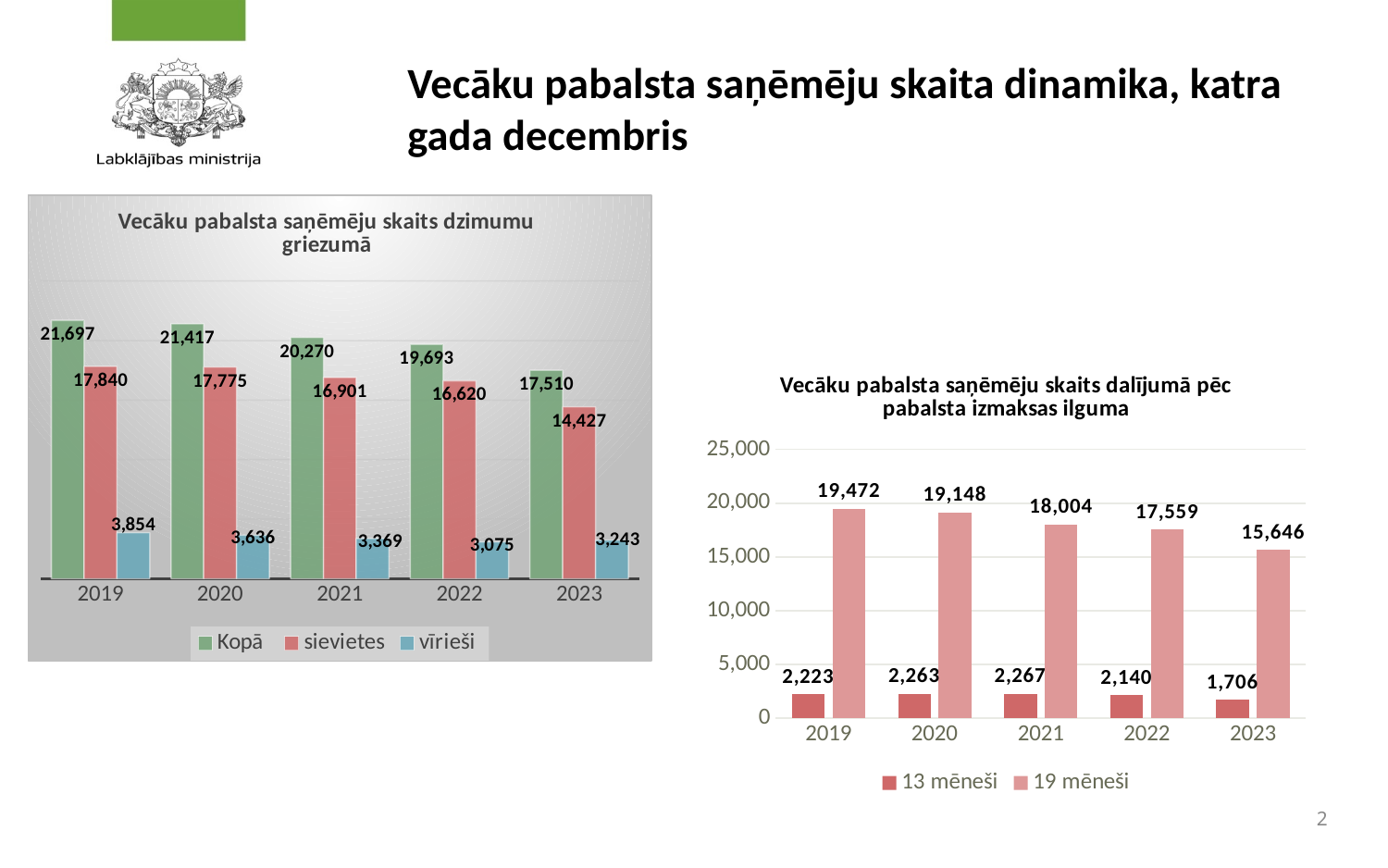
In the left chart (Vecāku pabalsta saņēmēju skaits dzimumu griezumā), what is the difference between the Kopā values for 2019 and 2023? 4,187 In the left chart (Vecāku pabalsta saņēmēju skaits dzimumu griezumā), which year has the lowest value for vīrieši? 2022 In the right chart (Vecāku pabalsta saņēmēju skaits dalījumā pēc pabalsta izmaksas ilguma), which year has the highest value for 13 mēneši? 2021 In the right chart (Vecāku pabalsta saņēmēju skaits dalījumā pēc pabalsta izmaksas ilguma), is the value for 19 mēneši in 2023 greater or less than 20,000? less In the left chart (Vecāku pabalsta saņēmēju skaits dzimumu griezumā), do the Kopā values rise or fall from 2019 to 2023? fall In the left chart (Vecāku pabalsta saņēmēju skaits dzimumu griezumā), what is the value for Kopā in 2019? 21,697 In the left chart (Vecāku pabalsta saņēmēju skaits dzimumu griezumā), what is the value for sievietes in 2023? 14,427 In the right chart (Vecāku pabalsta saņēmēju skaits dalījumā pēc pabalsta izmaksas ilguma), what is the value for 19 mēneši in 2021? 18,004 In the left chart (Vecāku pabalsta saņēmēju skaits dzimumu griezumā), how many series does the legend list? 3 In the right chart (Vecāku pabalsta saņēmēju skaits dalījumā pēc pabalsta izmaksas ilguma), how many years are shown on the x axis? 5 What kind of chart is the right chart (Vecāku pabalsta saņēmēju skaits dalījumā pēc pabalsta izmaksas ilguma)? bar chart In the right chart (Vecāku pabalsta saņēmēju skaits dalījumā pēc pabalsta izmaksas ilguma), what is the difference between the 19 mēneši and 13 mēneši values in 2023? 13,940